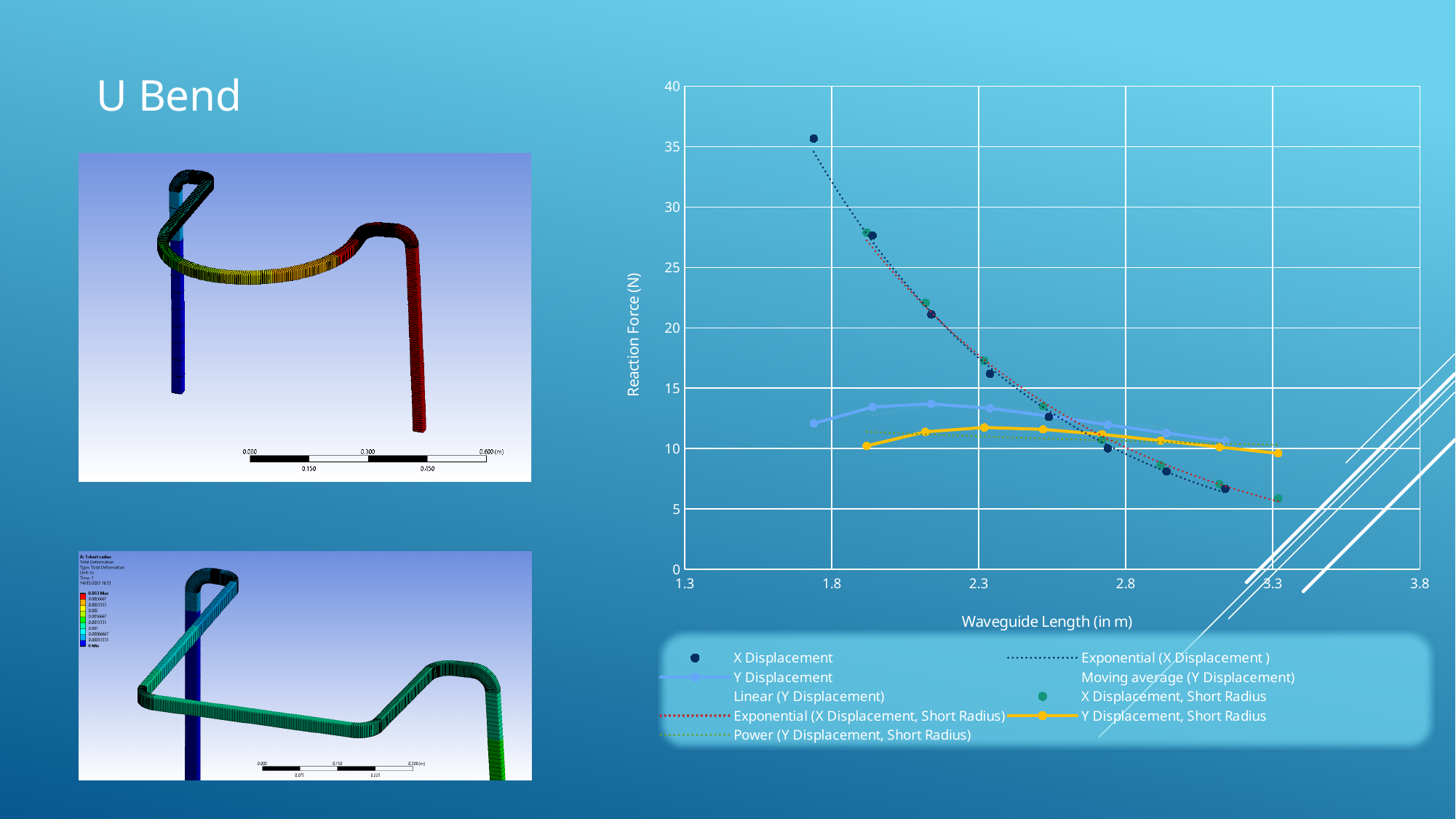
Is the Reaction Force of the first (leftmost) X Displacement point greater or less than 30? greater What is the title of the vertical axis of the chart? Reaction Force (N) Is the highest Reaction Force reached by the Y Displacement series greater or less than 15? less Which series reaches the highest Reaction Force on the chart? X Displacement Is the Reaction Force of the last (rightmost) X Displacement point greater or less than 10? less Do the X Displacement values rise or fall as Waveguide Length increases? fall What colour is the Y Displacement, Short Radius line in the chart? yellow At a Waveguide Length of about 2.3 m, which series has the larger Reaction Force: X Displacement or Y Displacement? X Displacement What kind of chart is shown on the slide? scatter chart At a Waveguide Length of about 2.5 m, which has the larger Reaction Force: Y Displacement or Y Displacement, Short Radius? Y Displacement How many data points are plotted for the X Displacement series? 8